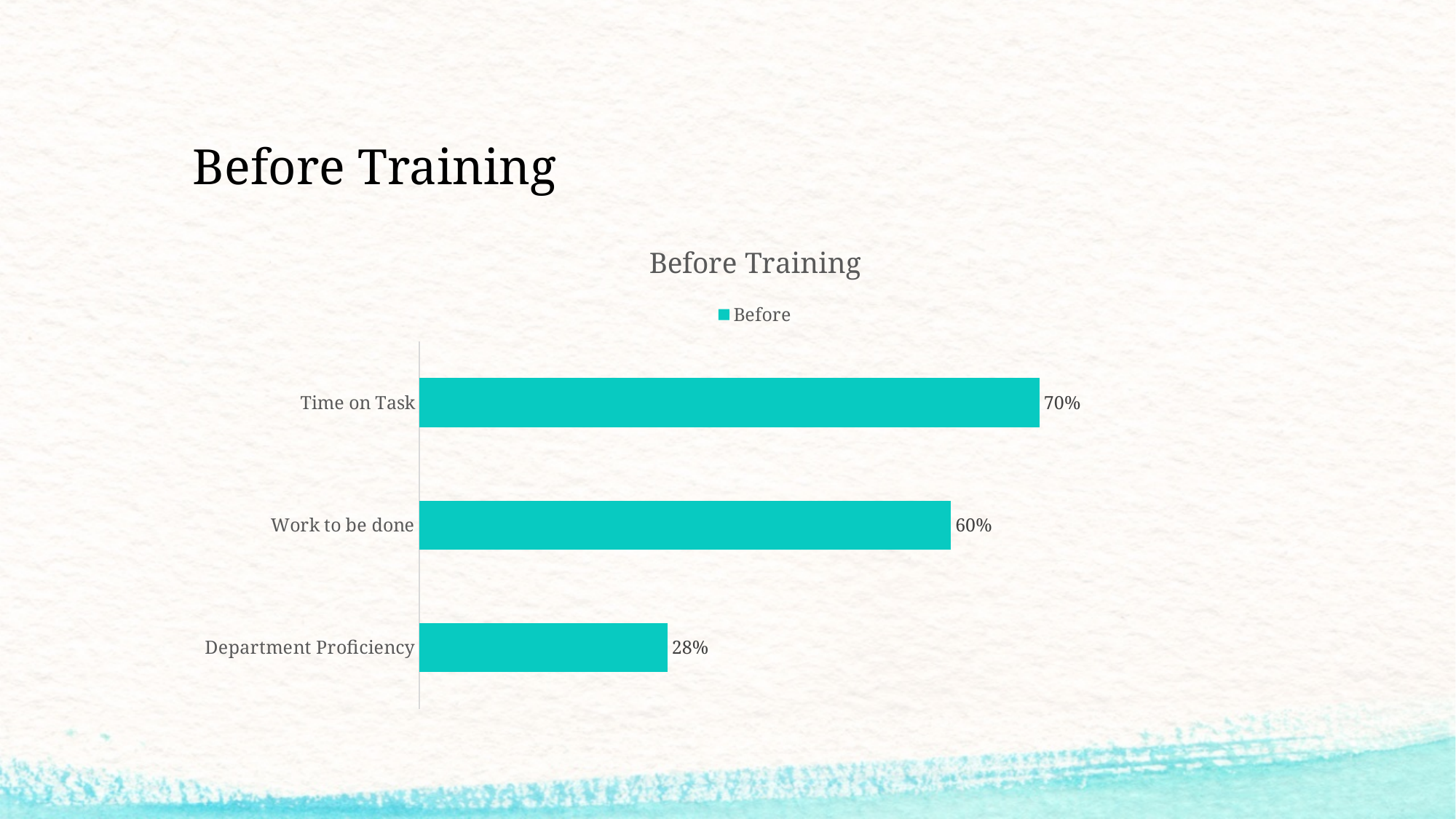
What is the title of the chart? Before Training How many series does the legend list? 1 What is the value for Time on Task? 70% What is the difference between the values for Time on Task and Department Proficiency? 42% What is the difference between the values for Time on Task and Work to be done? 10% How many categories are shown in the chart? 3 Which category has the lowest value? Department Proficiency Which is larger, the value for Work to be done or the value for Department Proficiency? Work to be done What is the value for Work to be done? 60% What is the value for Department Proficiency? 28% Which category has the highest value? Time on Task What kind of chart is shown on the slide? Bar chart